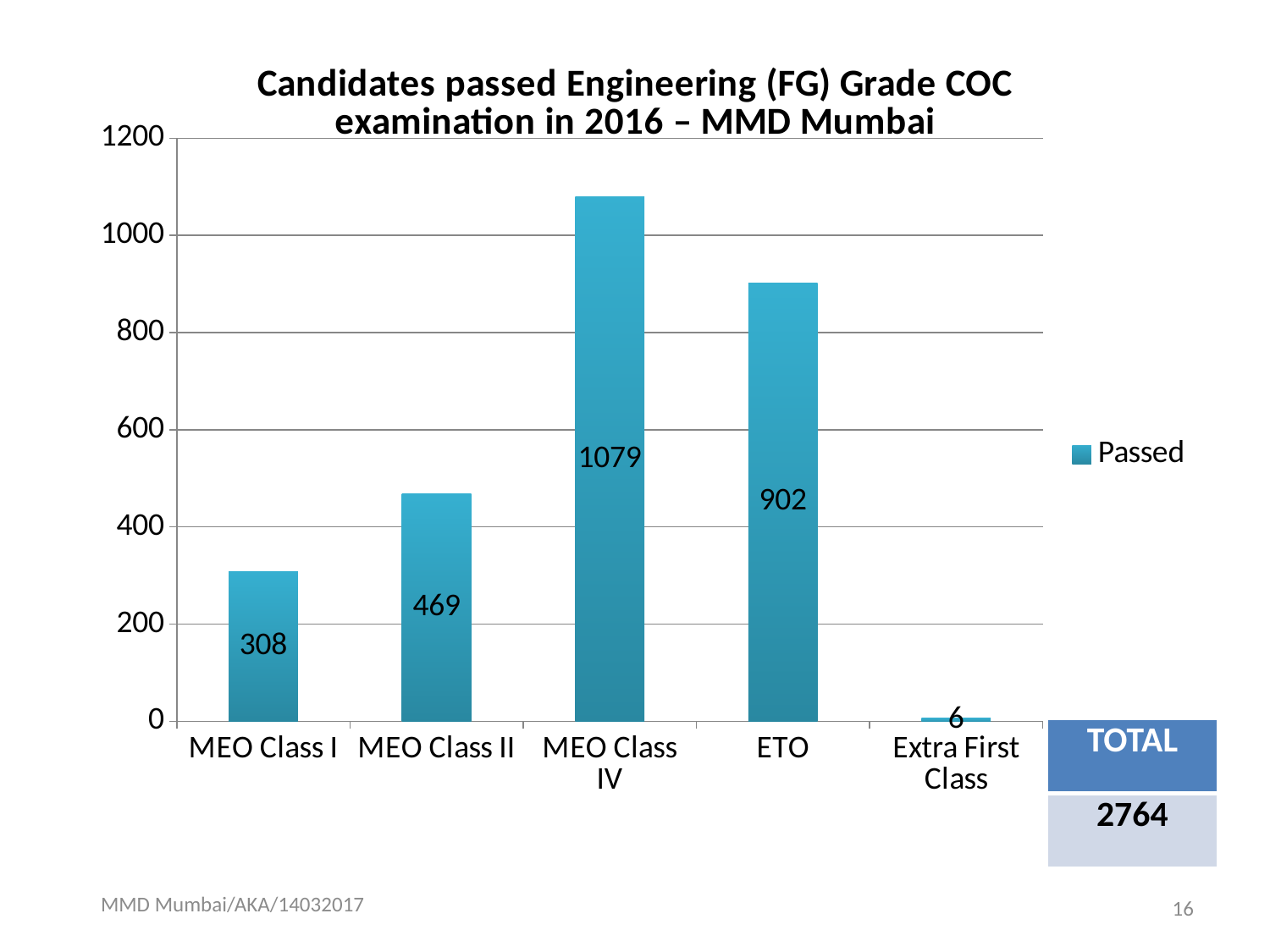
How many categories are shown on the x axis? 5 How many candidates passed in MEO Class IV? 1079 Which category has the highest number of candidates passed? MEO Class IV What is the value for ETO? 902 What is the title of the chart? Candidates passed Engineering (FG) Grade COC examination in 2016 – MMD Mumbai What kind of chart is shown on the slide? bar chart What is the value for MEO Class I? 308 What is the value for Extra First Class? 6 Which is larger, the value for MEO Class II or the value for MEO Class I? MEO Class II Which category has the lowest number of candidates passed? Extra First Class Is the value for MEO Class II greater or less than 400? greater What is the difference between the values for MEO Class IV and ETO? 177